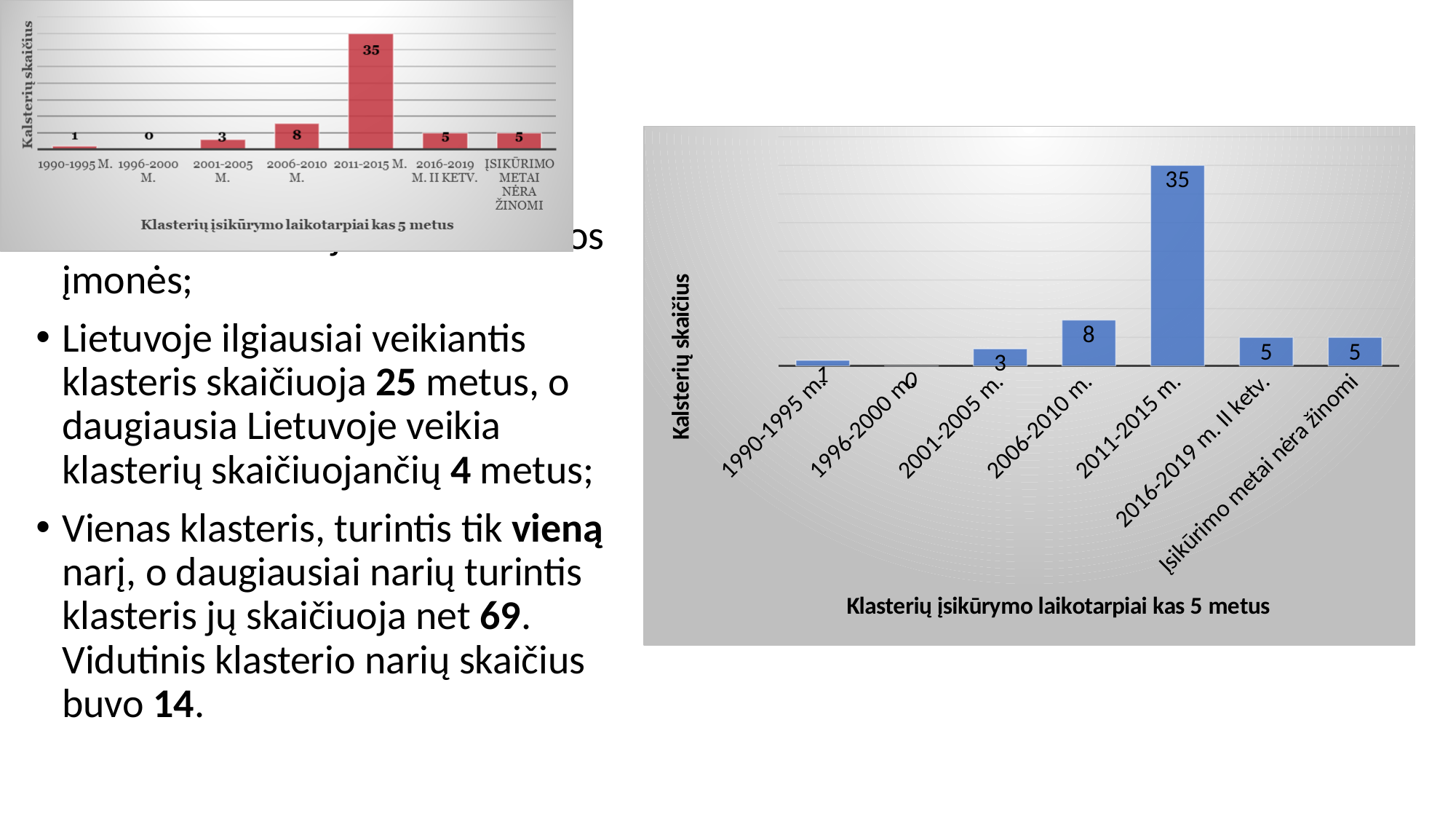
In the small chart at the top left, what is the value for 2016-2019 M. II KETV.? 5 What is the x-axis title of the chart on the right? Klasterių įsikūrymo laikotarpiai kas 5 metus In the chart on the right, what is the difference between the values for 2011-2015 m. and 2006-2010 m.? 27 In the small chart at the top left, what is the value for 1990-1995 M.? 1 In the chart on the right, what is the value for 2011-2015 m.? 35 In the chart on the right, which period has the lowest number of clusters? 1996-2000 m. How many categories are shown on the x axis of the chart on the right? 7 In the chart on the right, what is the value for 2006-2010 m.? 8 In the chart on the right, what is the value for 2001-2005 m.? 3 In the chart on the right, which is larger: the value for 2006-2010 m. or the value for 2016-2019 m. II ketv.? 2006-2010 m. In the chart on the right, which period has the highest number of clusters? 2011-2015 m. What kind of chart is the chart on the right? bar chart